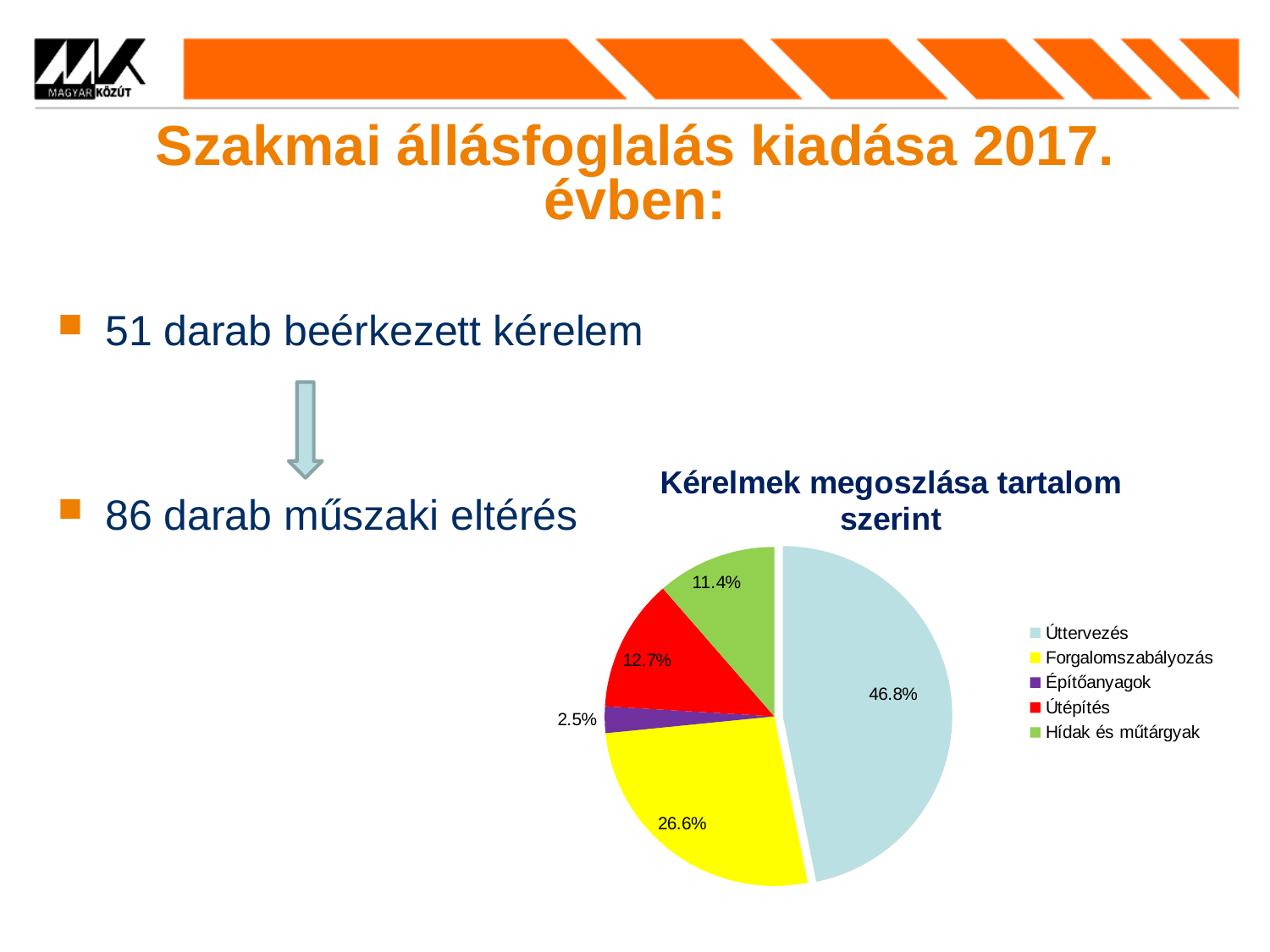
What is the difference between the shares of Úttervezés and Forgalomszabályozás? 20.2% What kind of chart is shown on the slide? pie chart Which category has the largest slice of the pie? Úttervezés What share of the pie does Úttervezés have? 46.8% What share of the pie does Építőanyagok have? 2.5% What is the title of the chart? Kérelmek megoszlása tartalom szerint What share of the pie does Forgalomszabályozás have? 26.6% How many categories does the pie chart show? 5 Which is larger, the share of Útépítés or the share of Hídak és műtárgyak? Útépítés Which category has the smallest slice of the pie? Építőanyagok